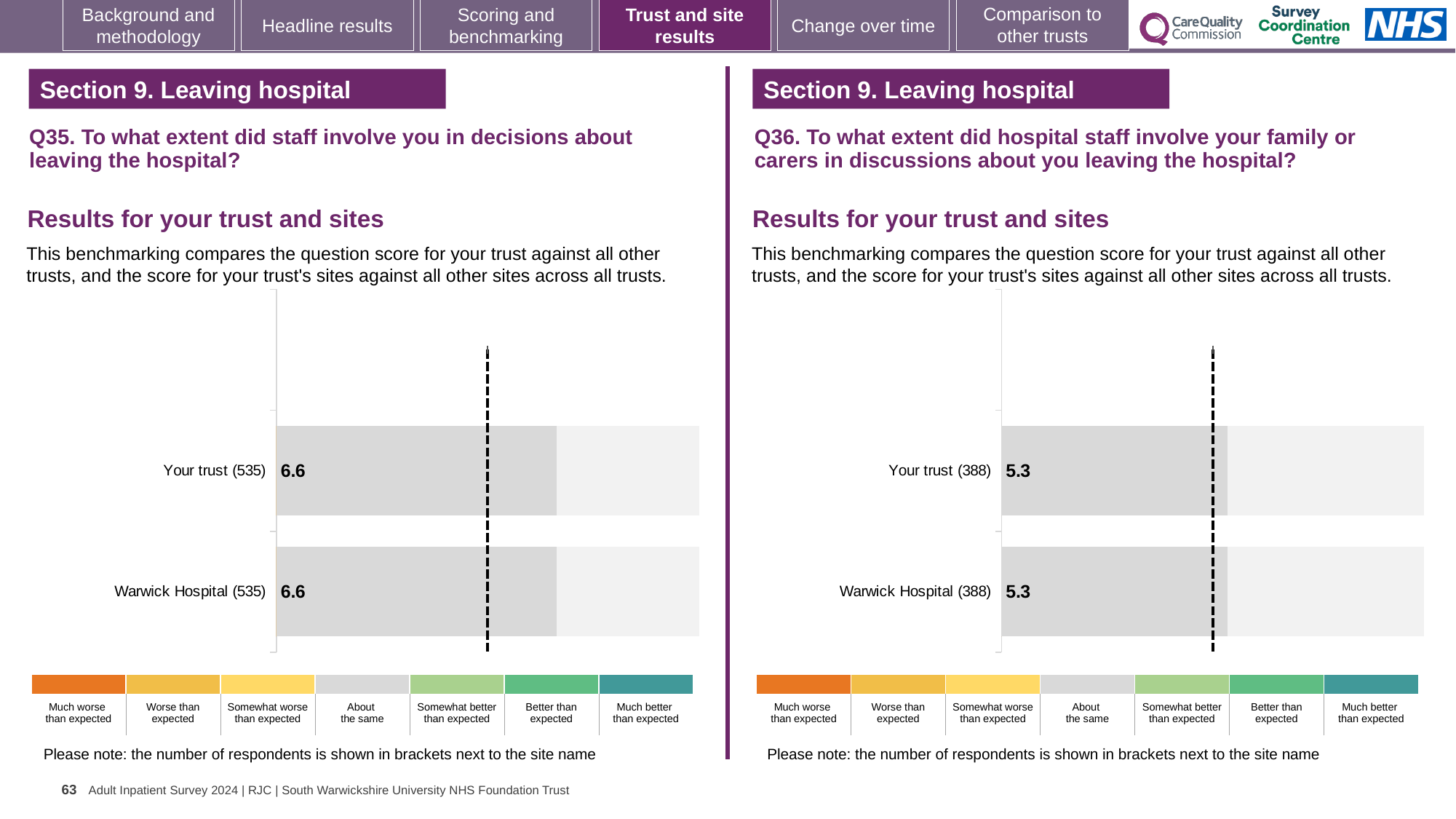
In the Q36 chart on the right, what is the difference between the score for Your trust and the score for Warwick Hospital? 0.0 In the Q35 chart on the left, what is the score for Warwick Hospital? 6.6 In the Q35 chart on the left, what is the score for Your trust? 6.6 In the Q36 chart on the right, what is the score for Your trust? 5.3 In the Q36 chart on the right, what is the score for Warwick Hospital? 5.3 In the Q35 chart on the left, how many respondents are shown in brackets for Warwick Hospital? 535 In the Q36 chart on the right, how many respondents are shown in brackets for Your trust? 388 In the Q36 chart on the right, which benchmark category does the grey colour of the bars correspond to in the legend? About the same How many bars are plotted in the Q35 chart on the left? 2 How many bars are plotted in the Q36 chart on the right? 2 What kind of chart is the Q35 chart on the left? Bar chart In the Q35 chart on the left, what is the difference between the score for Your trust and the score for Warwick Hospital? 0.0